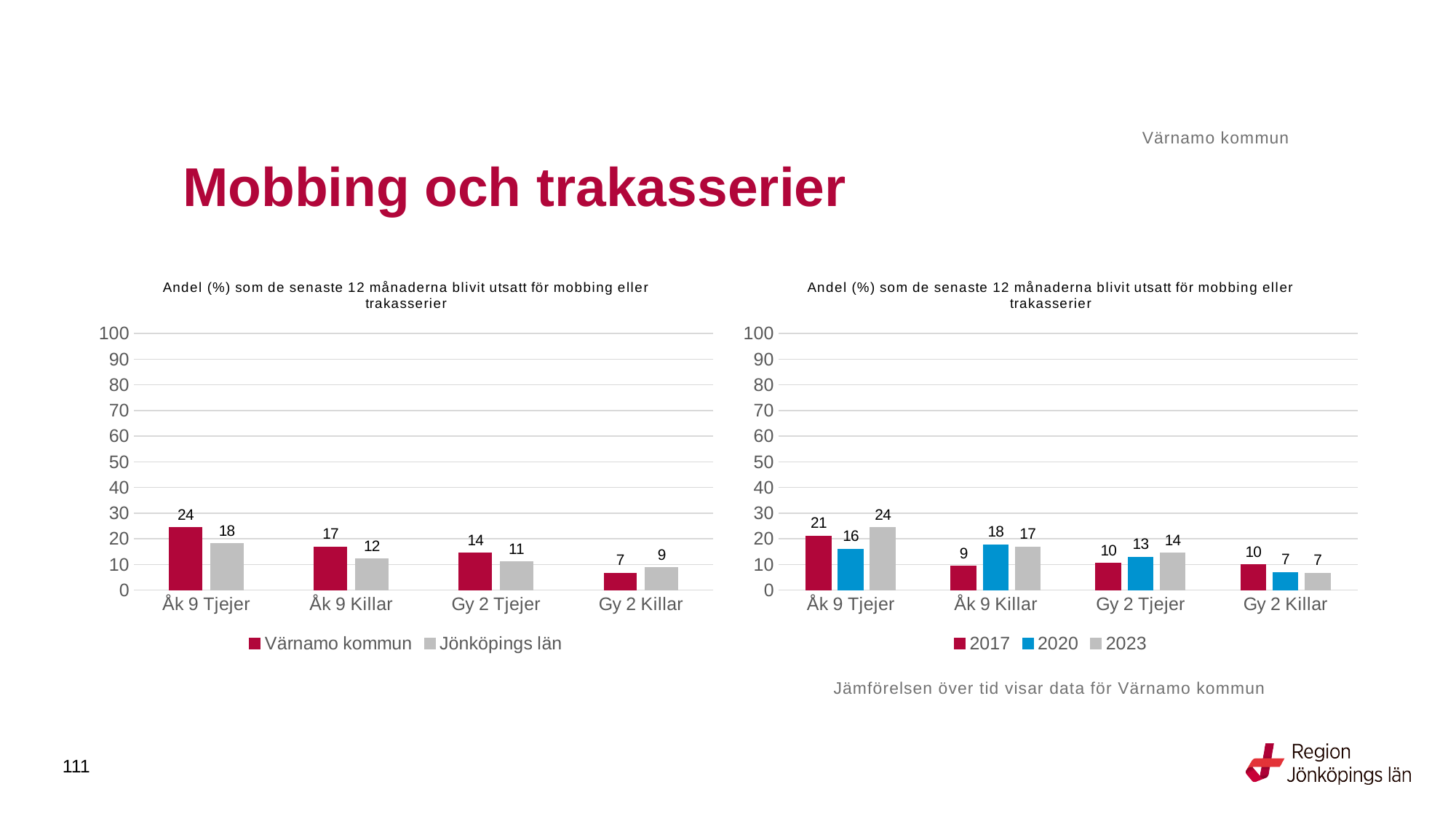
In the right chart, what is the value for 2023 for Gy 2 Tjejer? 14 In the right chart, how many categories are shown on the x axis? 4 In the left chart, what is the value for Värnamo kommun for Åk 9 Tjejer? 24 In the left chart, how many series does the legend list? 2 In the right chart, what is the difference between 2017 and 2020 for Åk 9 Killar? 9 In the left chart, what is the value for Jönköpings län for Gy 2 Killar? 9 In the left chart, what is the difference between Värnamo kommun and Jönköpings län for Åk 9 Tjejer? 6 In the left chart, which is larger for Gy 2 Killar: Värnamo kommun or Jönköpings län? Jönköpings län What kind of chart is the right chart? Bar chart In the left chart, which category has the lowest value for Värnamo kommun? Gy 2 Killar In the right chart, which year has the highest value for Åk 9 Tjejer? 2023 In the right chart, what is the value for 2020 for Åk 9 Killar? 18